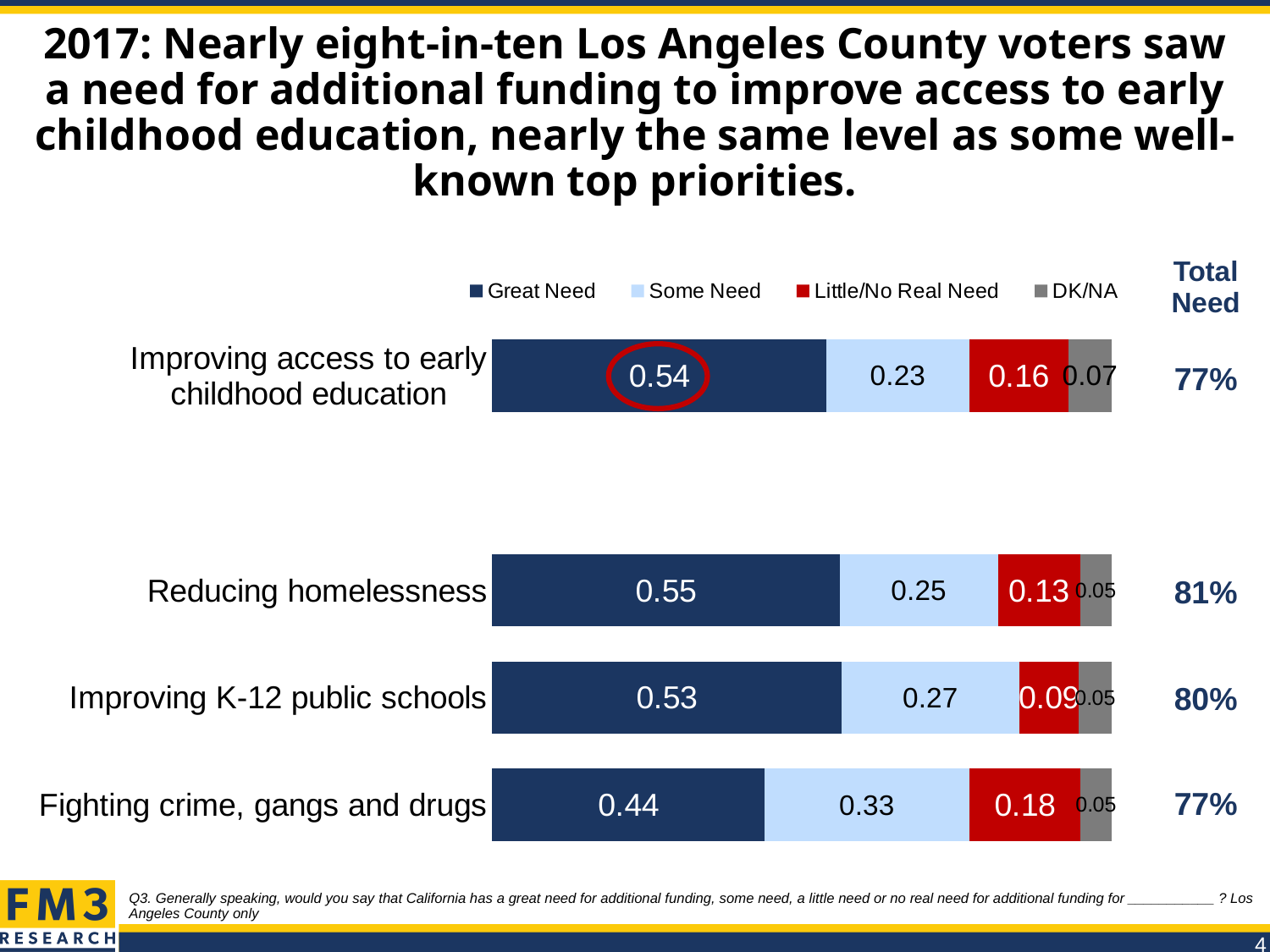
How many series does the legend list? 4 What is the Some Need value for Fighting crime, gangs and drugs? 0.33 What is the Little/No Real Need value for Improving K-12 public schools? 0.09 Which category has the lowest Great Need value? Fighting crime, gangs and drugs What Total Need percentage is shown for Reducing homelessness? 81% What is the Great Need value for Improving access to early childhood education? 0.54 What is the DK/NA value for Improving access to early childhood education? 0.07 Which has the larger Little/No Real Need value: Fighting crime, gangs and drugs or Improving K-12 public schools? Fighting crime, gangs and drugs Which category has the highest Some Need value? Fighting crime, gangs and drugs What is the difference between the Some Need values for Fighting crime, gangs and drugs and Improving access to early childhood education? 0.10 What kind of chart is shown on the slide? Stacked bar chart How many categories are shown in the chart? 4